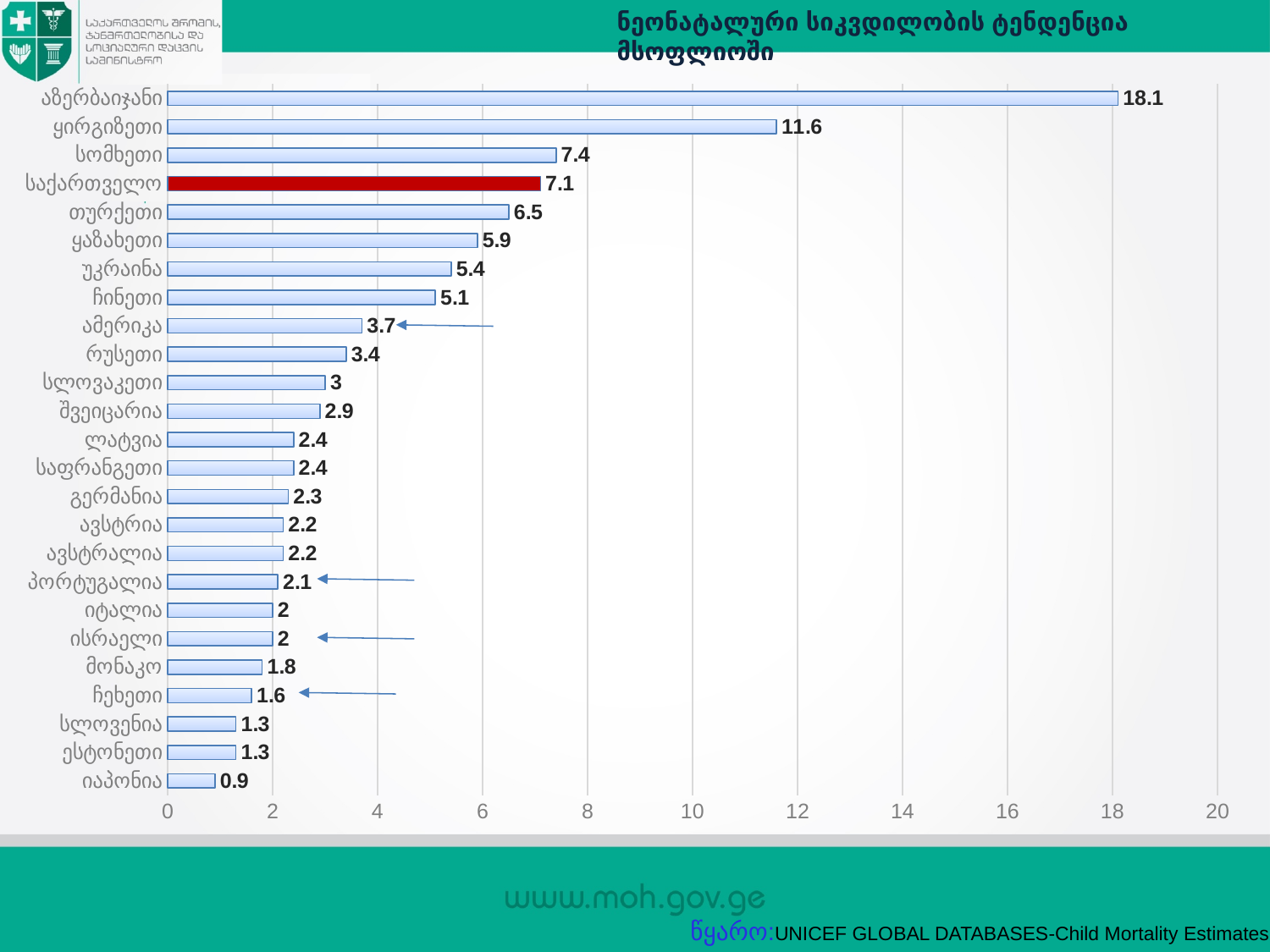
How many categories are shown in the chart? 25 What kind of chart is shown on the slide? bar chart What is the value for აზერბაიჯანი? 18.1 What is the difference between the values for აზერბაიჯანი and ყირგიზეთი? 6.5 What is the value for იაპონია? 0.9 What is the value for ჩინეთი? 5.1 Is the value for ყირგიზეთი greater or less than 10? greater Which category has the lowest value? იაპონია Which bar is highlighted in a different colour (red) from the others? საქართველო What is the value for საქართველო? 7.1 Which is larger, the value for თურქეთი or the value for უკრაინა? თურქეთი Which category has the highest value? აზერბაიჯანი